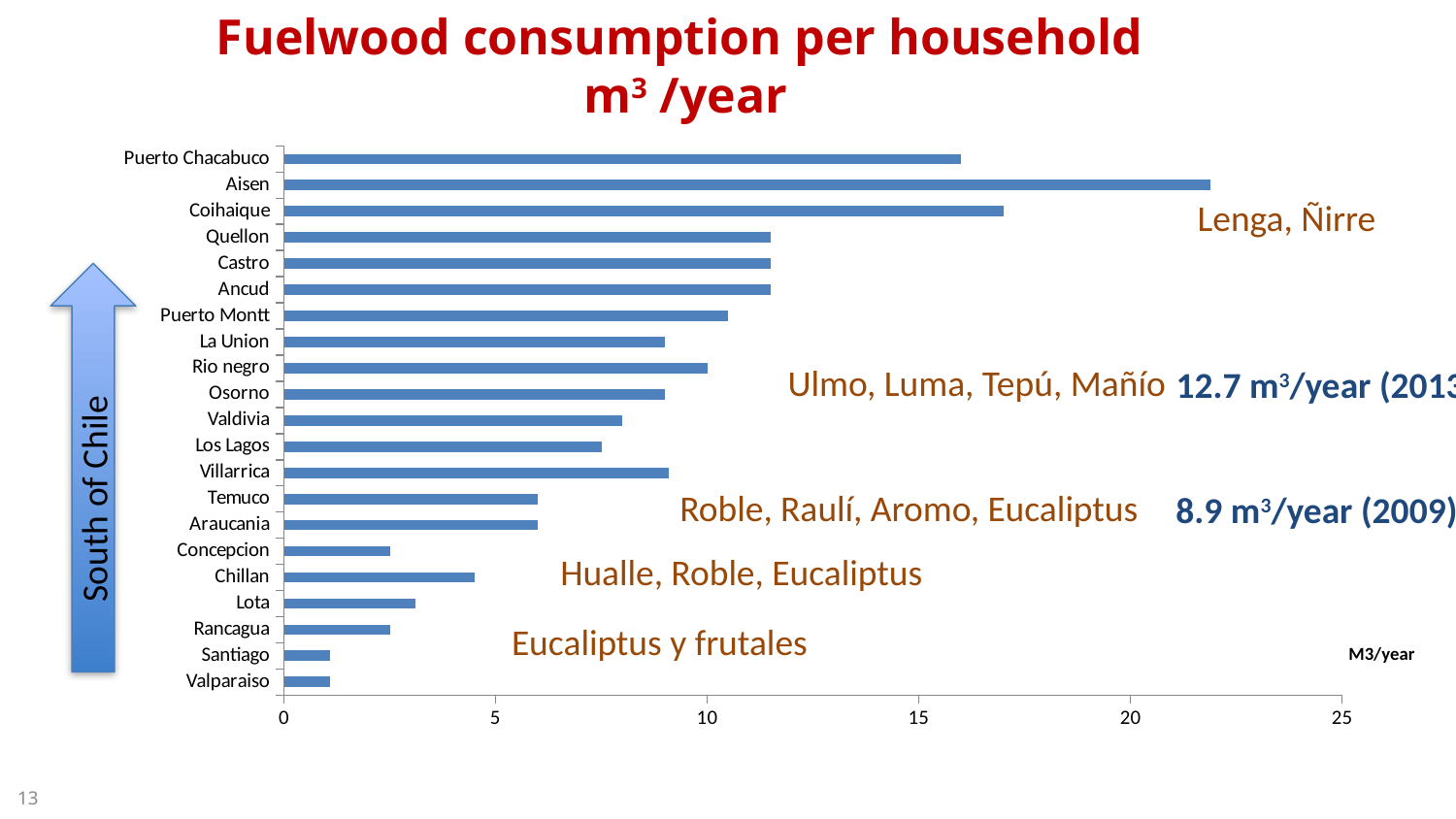
What is the title of the chart? Fuelwood consumption per household m³ /year What kind of chart is shown on the slide? bar chart Which has the larger value, Aisen or Coihaique? Aisen Which has the larger value, Puerto Chacabuco or Quellon? Puerto Chacabuco Is the value for Aisen greater or less than 20? greater Is the value for Chillan greater or less than 5? less Is the value for Puerto Chacabuco greater or less than 15? greater What is the highest value shown on the horizontal axis? 25 Which city has the highest fuelwood consumption per household? Aisen How many cities or regions are listed on the chart? 21